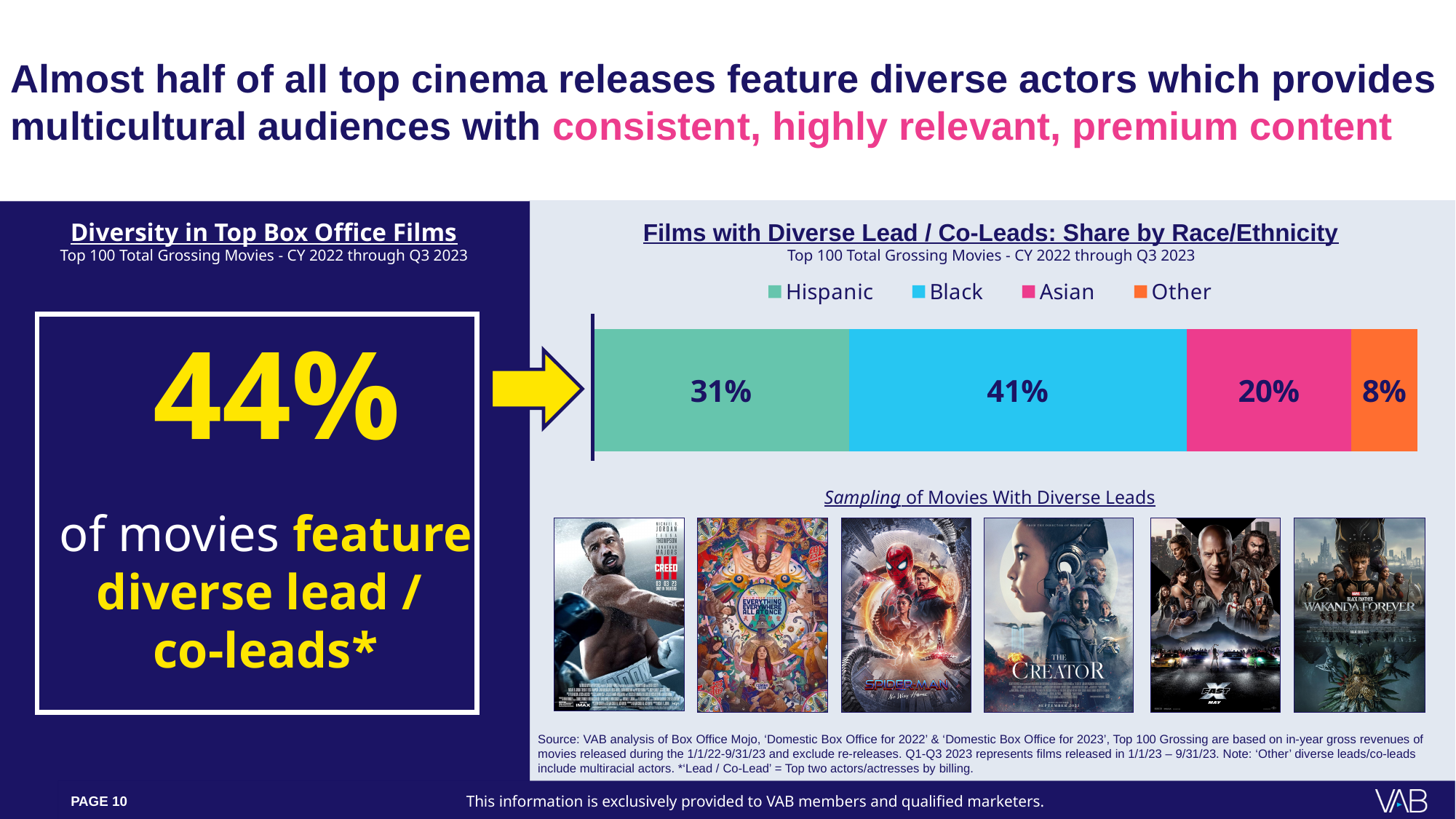
In the 'Films with Diverse Lead / Co-Leads: Share by Race/Ethnicity' chart, what share is shown for Other? 8% In the 'Films with Diverse Lead / Co-Leads: Share by Race/Ethnicity' chart, which race/ethnicity has the smallest share? Other What kind of chart is the 'Films with Diverse Lead / Co-Leads: Share by Race/Ethnicity' chart? Stacked bar chart In the 'Films with Diverse Lead / Co-Leads: Share by Race/Ethnicity' chart, what colour represents Black in the legend? Light blue In the 'Films with Diverse Lead / Co-Leads: Share by Race/Ethnicity' chart, what share is shown for Asian? 20% In the 'Films with Diverse Lead / Co-Leads: Share by Race/Ethnicity' chart, what share is shown for Hispanic? 31% In the 'Films with Diverse Lead / Co-Leads: Share by Race/Ethnicity' chart, what is the difference between the Asian and Other shares? 12% In the 'Films with Diverse Lead / Co-Leads: Share by Race/Ethnicity' chart, which is larger, the Hispanic share or the Asian share? Hispanic How many series does the legend of the 'Films with Diverse Lead / Co-Leads: Share by Race/Ethnicity' chart list? 4 In the 'Films with Diverse Lead / Co-Leads: Share by Race/Ethnicity' chart, what share is shown for Black? 41% In the 'Films with Diverse Lead / Co-Leads: Share by Race/Ethnicity' chart, what is the difference between the Black and Hispanic shares? 10% In the 'Films with Diverse Lead / Co-Leads: Share by Race/Ethnicity' chart, which race/ethnicity has the largest share? Black